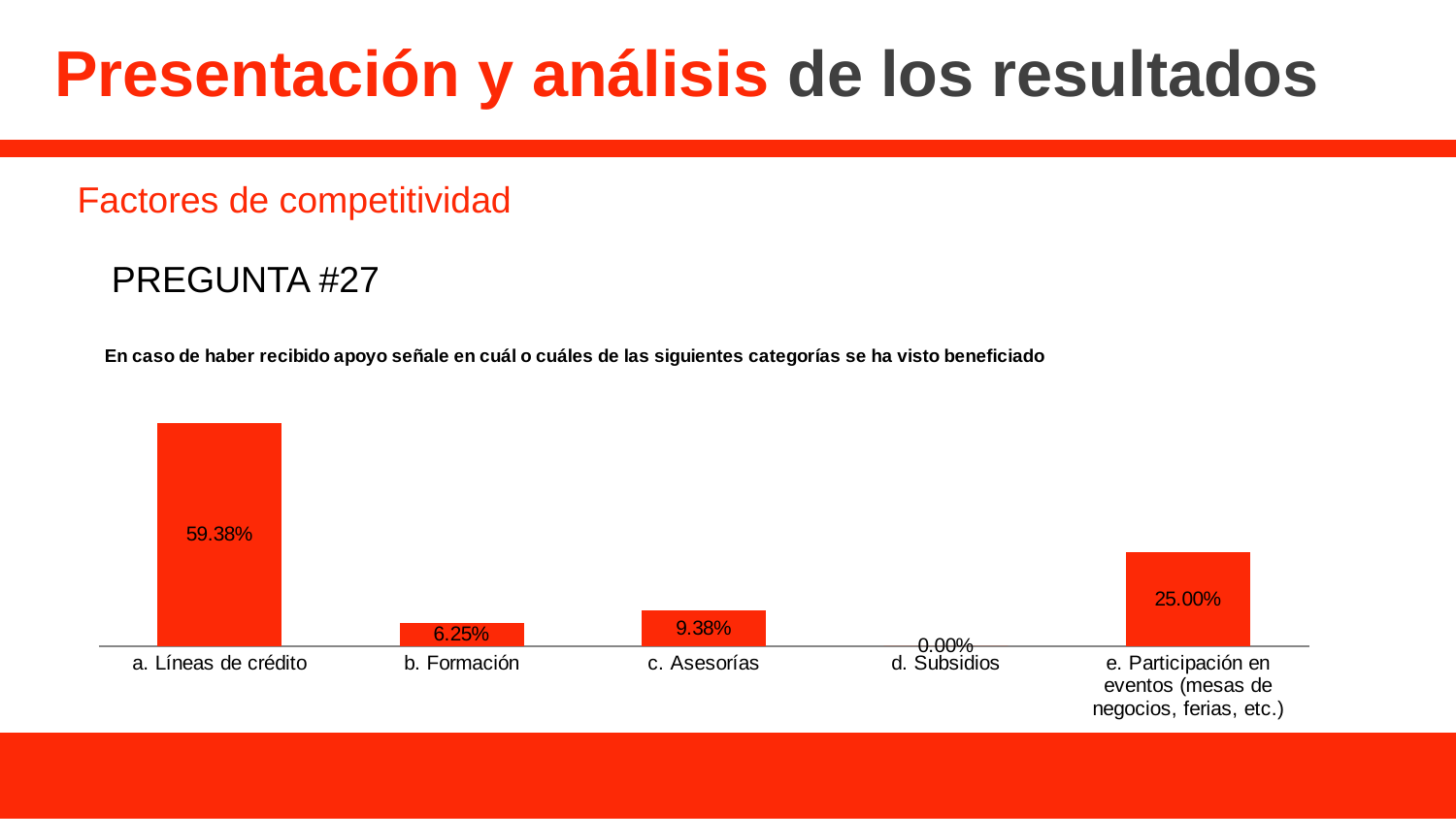
What is the value for c. Asesorías? 9.38% What kind of chart is shown on the slide? Bar chart Which is larger, the value for b. Formación or c. Asesorías? c. Asesorías Which category has the lowest value? d. Subsidios What is the value for b. Formación? 6.25% What is the value for e. Participación en eventos (mesas de negocios, ferias, etc.)? 25.00% What is the value for a. Líneas de crédito? 59.38% How many categories are shown in the chart? 5 Which category has the highest value? a. Líneas de crédito What is the chart's title? En caso de haber recibido apoyo señale en cuál o cuáles de las siguientes categorías se ha visto beneficiado What is the value for d. Subsidios? 0.00% What is the difference between the values for a. Líneas de crédito and e. Participación en eventos? 34.38%